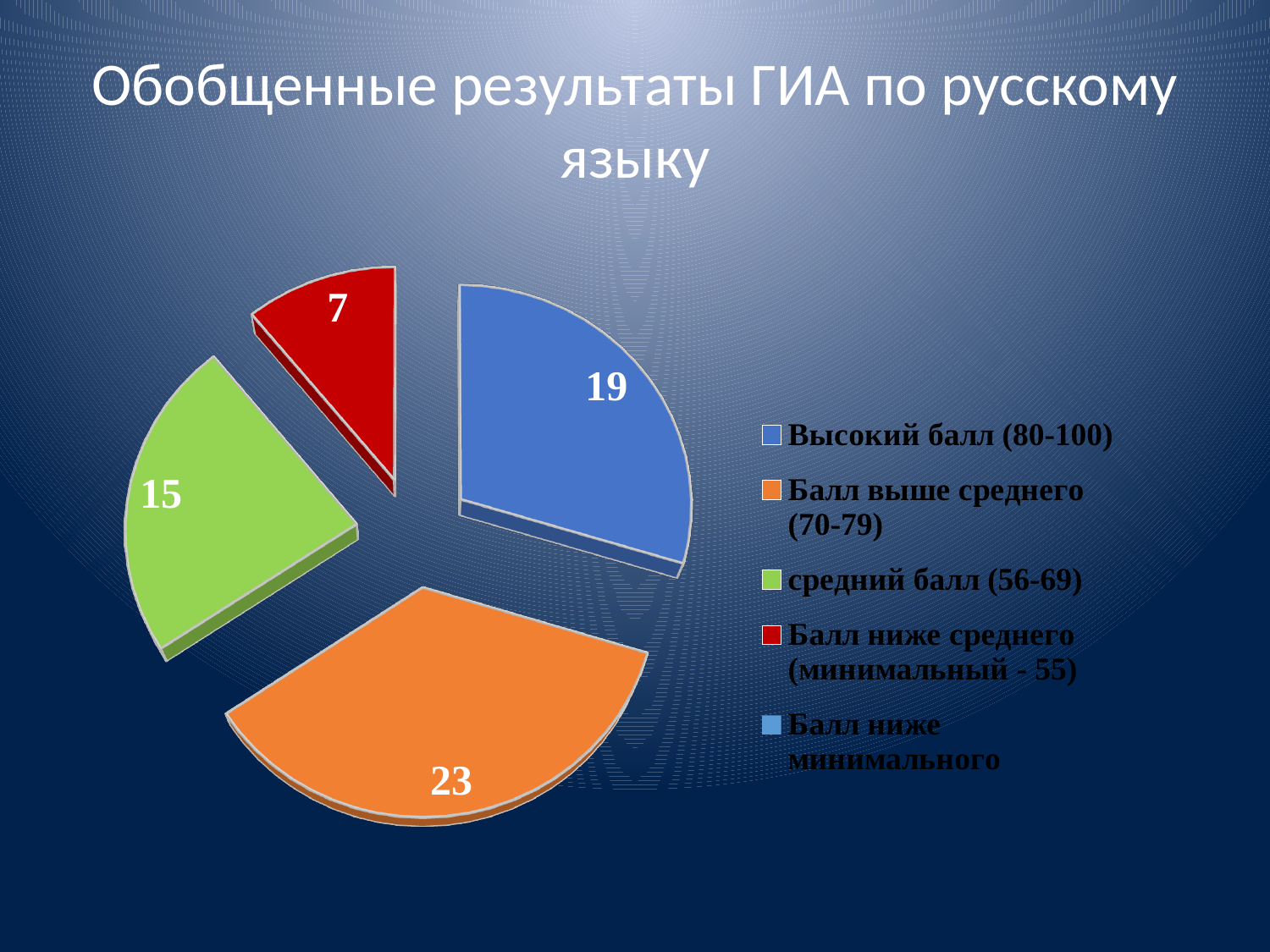
Which category has the largest slice? Балл выше среднего (70-79) What is the value for Высокий балл (80-100)? 19 How many slices are drawn in the pie chart? 4 What is the value for средний балл (56-69)? 15 How many entries does the legend list? 5 What is the value for Балл ниже среднего (минимальный - 55)? 7 What type of chart is shown on the slide? pie chart What is the value for Балл выше среднего (70-79)? 23 What is the title of the slide? Обобщенные результаты ГИА по русскому языку Which is larger: the value for средний балл (56-69) or the value for Балл ниже среднего (минимальный - 55)? средний балл (56-69) Which labelled slice has the smallest value? Балл ниже среднего (минимальный - 55) What is the difference between the values for Балл выше среднего (70-79) and Высокий балл (80-100)? 4